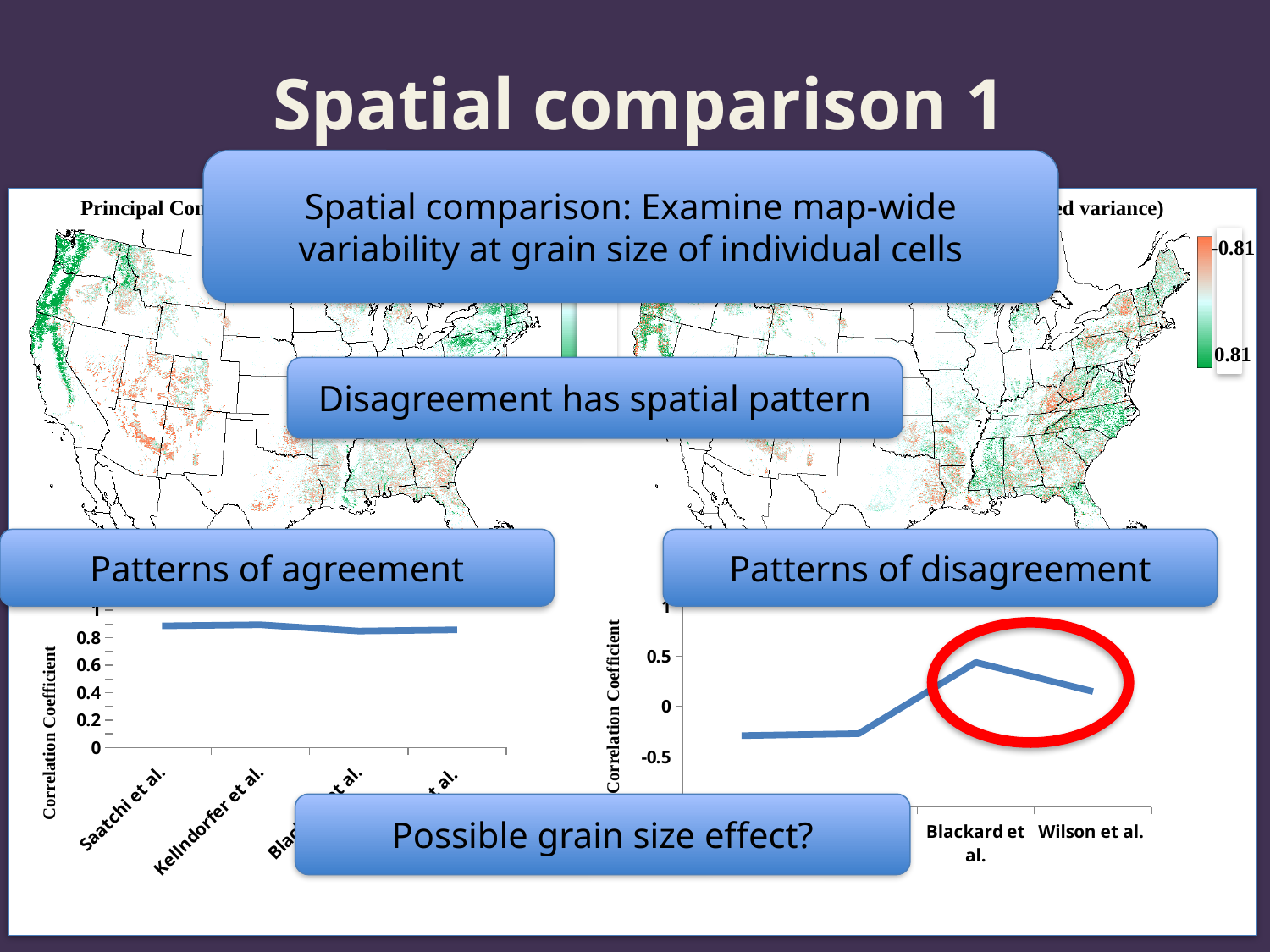
On the 'Patterns of disagreement' chart, is the value for Wilson et al. greater or less than 0.5? less How many data points are plotted on the 'Patterns of agreement' line chart? 4 On the 'Patterns of disagreement' chart, is the value for Blackard et al. greater or less than 0? greater What is the y-axis title of the 'Patterns of disagreement' chart? Correlation Coefficient On the 'Patterns of disagreement' chart, does the line rise or fall between Blackard et al. and Wilson et al.? falls On the 'Patterns of agreement' chart, is the value for Kellndorfer et al. greater or less than 0.6? greater What is the lowest tick value shown on the y-axis of the 'Patterns of disagreement' chart? -0.5 On the 'Patterns of disagreement' chart, which labelled point has the highest correlation coefficient? Blackard et al. What kind of chart is the 'Patterns of agreement' chart at the bottom left of the slide? line chart On the 'Patterns of disagreement' chart, which has the larger value, Blackard et al. or Wilson et al.? Blackard et al. What kind of chart is the 'Patterns of disagreement' chart at the bottom right of the slide? line chart